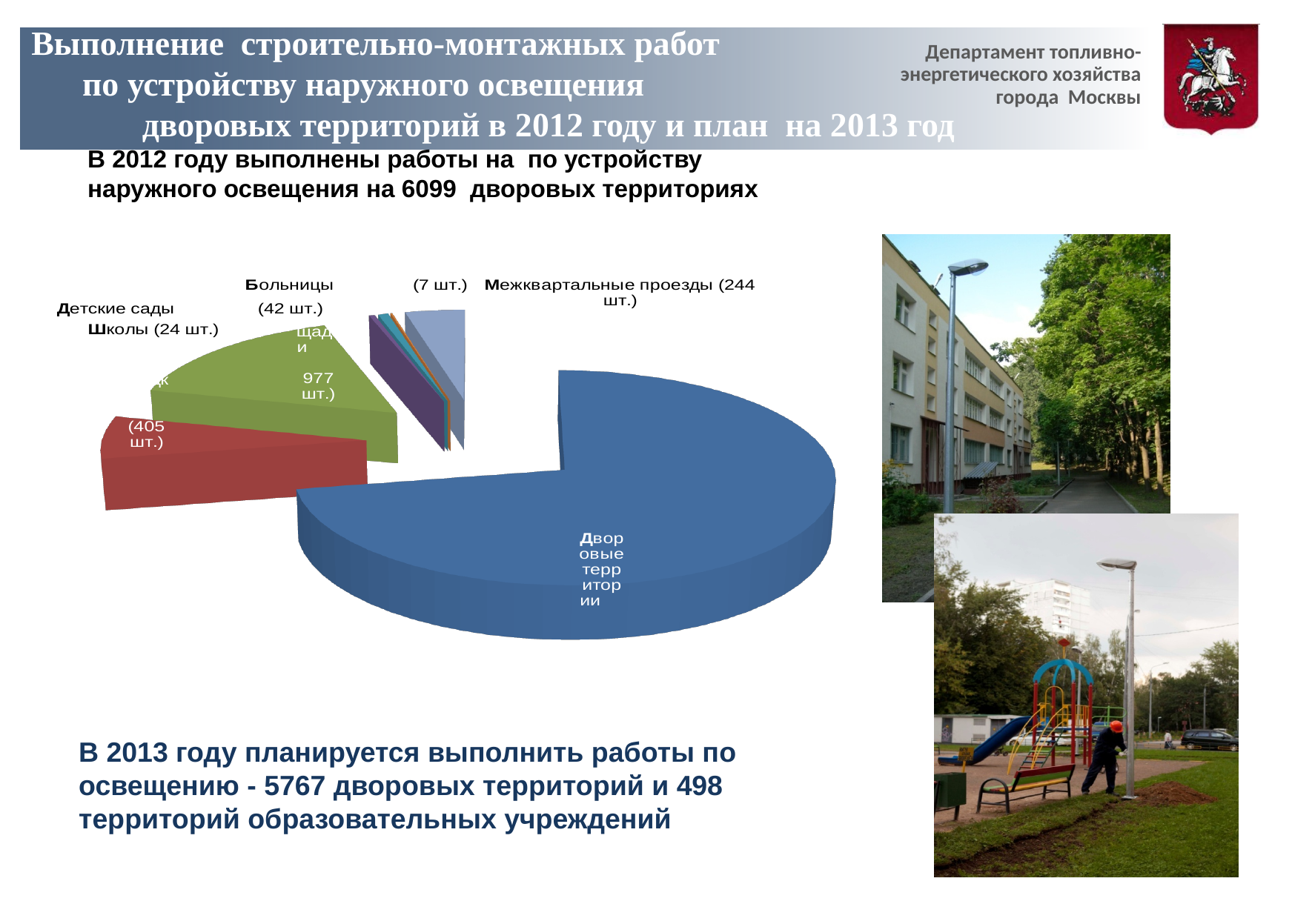
What value is shown for Школы in the pie chart? 24 шт. What type of chart is shown on the slide? pie chart Which category has the largest slice in the pie chart? Дворовые территории What value is shown for Больницы in the pie chart? 42 шт. Which is larger, the value for Межквартальные проезды or the value for Школы? Межквартальные проезды What value is shown for Межквартальные проезды in the pie chart? 244 шт. What is the difference between the values for Межквартальные проезды and Больницы? 202 шт. What colour is the slice for Дворовые территории in the pie chart? blue What is the difference between the values for Больницы and Школы? 18 шт. Which is larger, the value for Больницы or the value for Школы? Больницы